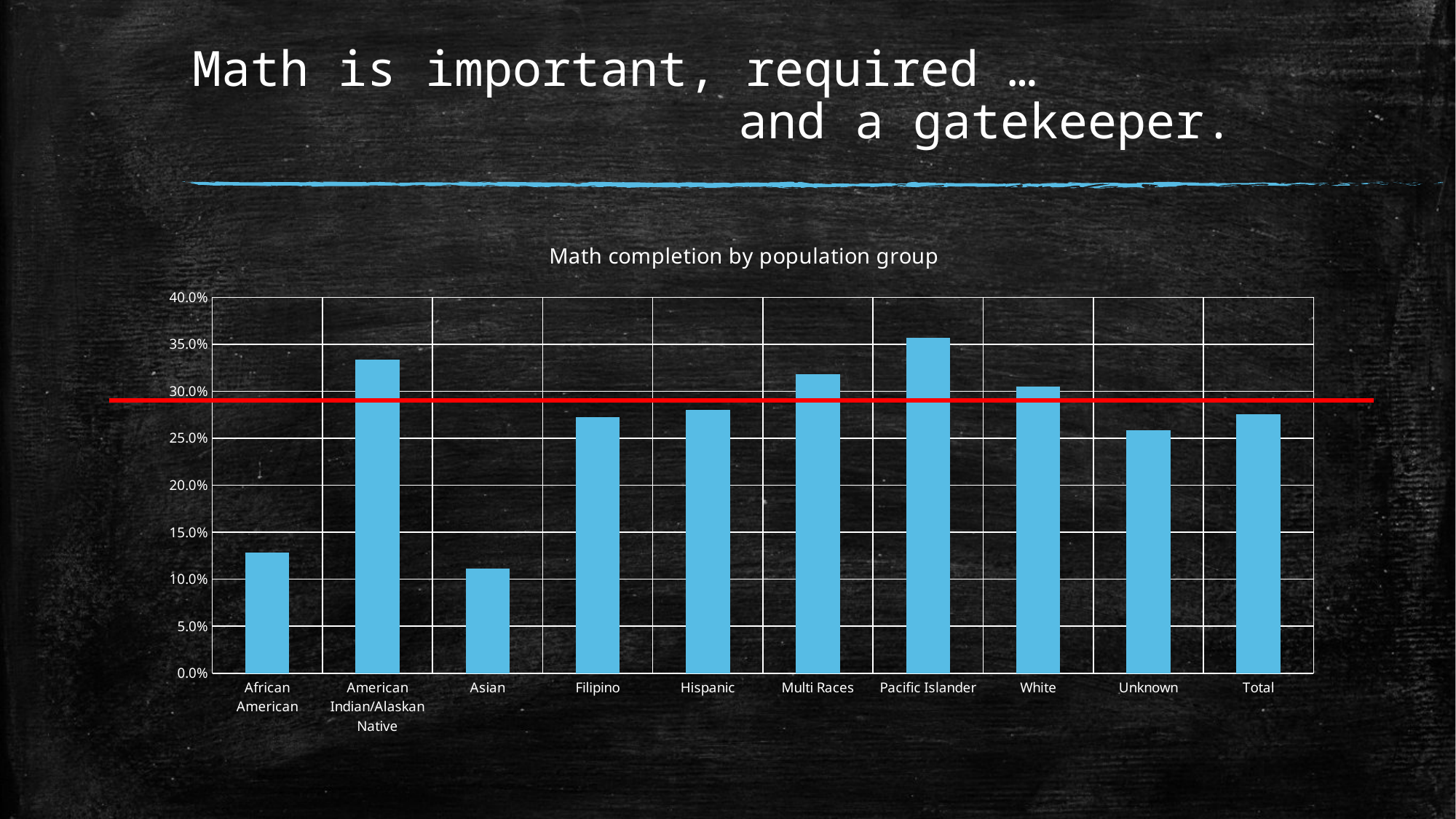
Which has a higher math completion rate, Multi Races or Hispanic? Multi Races Is the value for Filipino greater or less than 25.0%? greater Which population group has the lowest math completion rate? Asian What kind of chart is shown on the slide? bar chart How many population groups are shown on the x axis of the chart? 10 Is the value for Total greater or less than 30.0%? less Which population group has the highest math completion rate? Pacific Islander Is the value for African American greater or less than 15.0%? less Which has a higher math completion rate, Asian or American Indian/Alaskan Native? American Indian/Alaskan Native What is the title of the chart? Math completion by population group